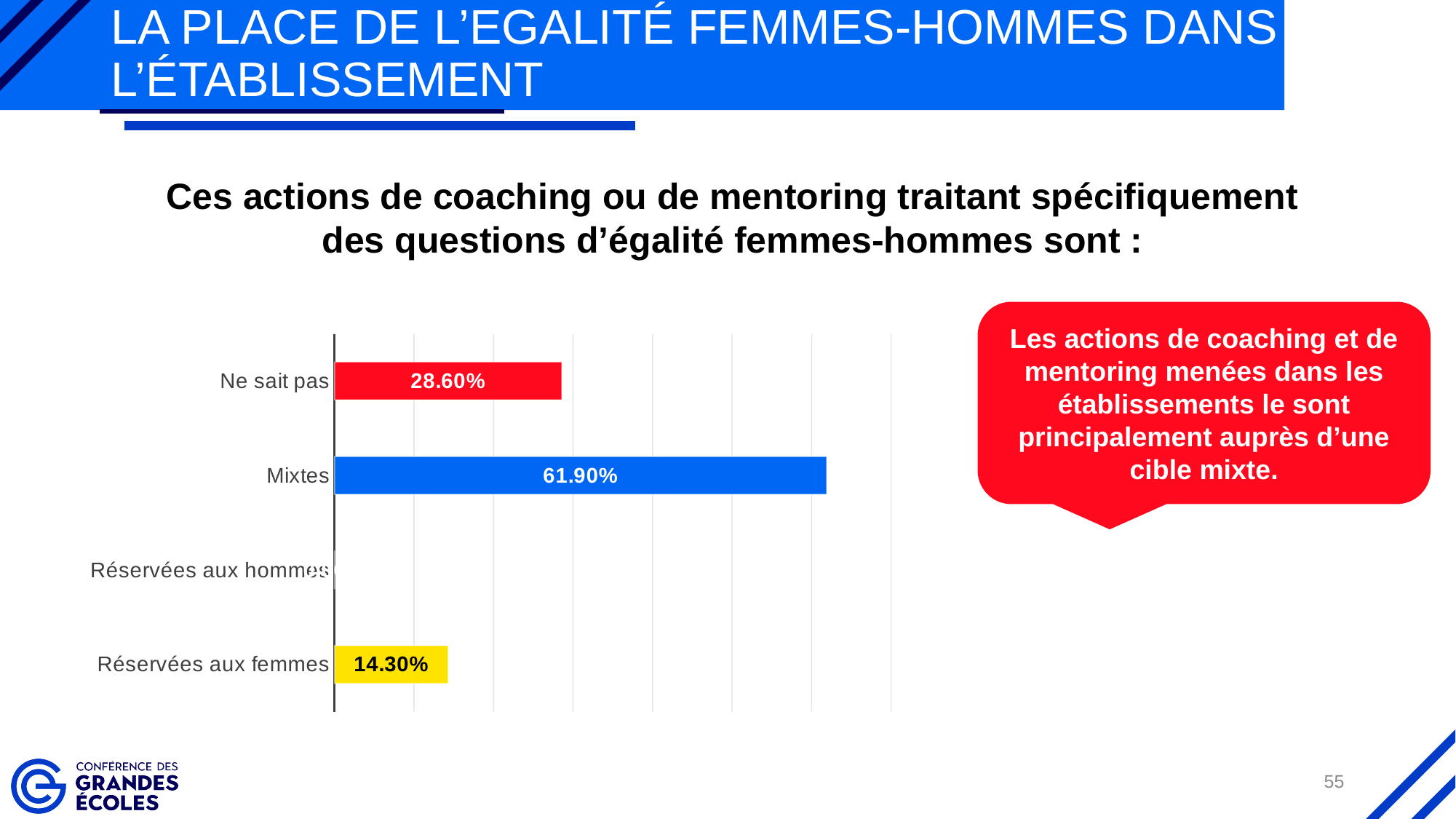
What is the difference between the values for Mixtes and Ne sait pas? 33.30% What is the value for Ne sait pas? 28.60% Which is larger, the value for Ne sait pas or the value for Réservées aux femmes? Ne sait pas What colour is the bar for Mixtes? Blue What is the value for Réservées aux femmes? 14.30% What is the value for Mixtes? 61.90% What is the difference between the values for Mixtes and Réservées aux femmes? 47.60% How many categories are shown on the chart? 4 Which category has the highest value? Mixtes What kind of chart is shown on the slide? Bar chart Which category has the lowest value? Réservées aux hommes What is the difference between the values for Ne sait pas and Réservées aux femmes? 14.30%